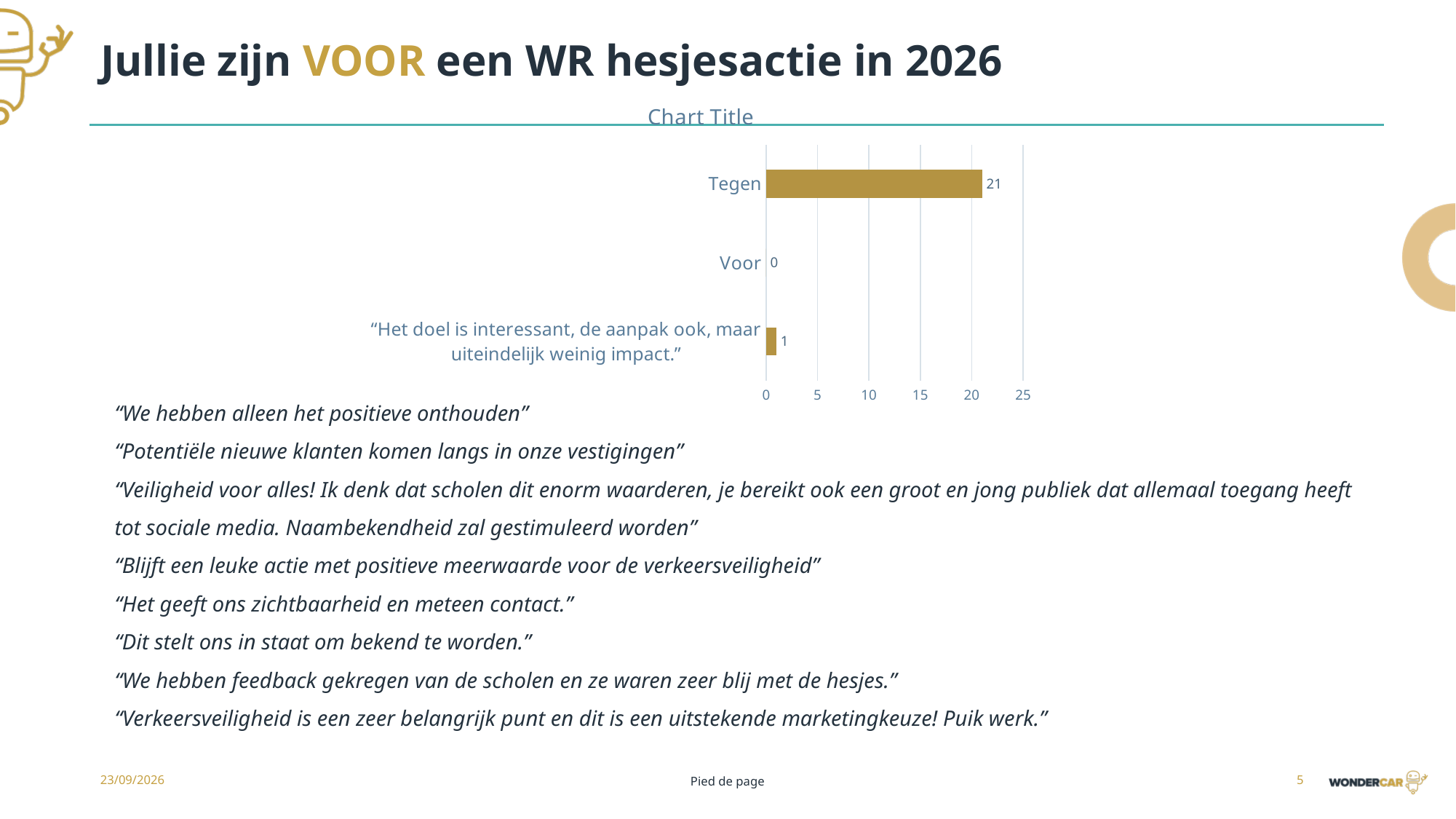
What is the difference between the values for Tegen and Voor? 21 Which category has the highest value? Tegen What kind of chart is shown on the slide? Bar chart What is the value for the category "Het doel is interessant, de aanpak ook, maar uiteindelijk weinig impact."? 1 What is the difference between the values for Tegen and "Het doel is interessant, de aanpak ook, maar uiteindelijk weinig impact."? 20 Is the value for Tegen greater or less than 20? greater What is the value for Tegen? 21 Which category has the lowest value? Voor What is the title shown above the chart? Chart Title What is the value for Voor? 0 How many categories are shown in the chart? 3 Which is larger, the value for Tegen or the value for Voor? Tegen